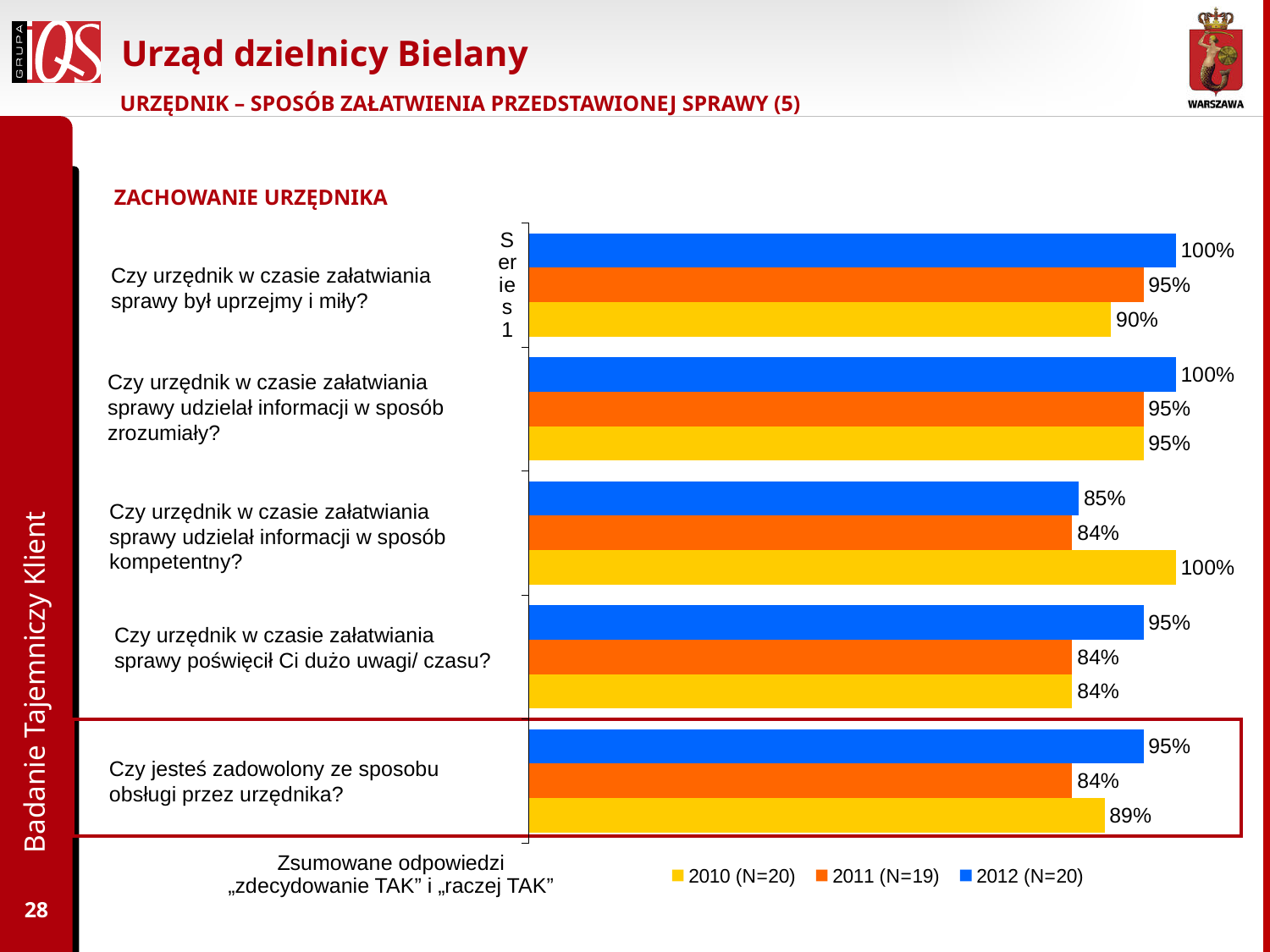
For "Czy urzędnik w czasie załatwiania sprawy udzielał informacji w sposób zrozumiały?", what is the difference between the 2012 (N=20) and 2011 (N=19) values? 5% What kind of chart is shown on the slide? bar chart What is the 2011 (N=19) value for "Czy urzędnik w czasie załatwiania sprawy poświęcił Ci dużo uwagi/ czasu?"? 84% How many series does the legend list? 3 Which colour represents the 2010 (N=20) series in the legend? yellow Which series has the lowest value for "Czy urzędnik w czasie załatwiania sprawy udzielał informacji w sposób kompetentny?"? 2011 (N=19) How many question categories are plotted on the chart? 5 What is the 2010 (N=20) value for "Czy jesteś zadowolony ze sposobu obsługi przez urzędnika?"? 89% For "Czy urzędnik w czasie załatwiania sprawy był uprzejmy i miły?", what is the difference between the 2012 (N=20) and 2010 (N=20) values? 10% For "Czy jesteś zadowolony ze sposobu obsługi przez urzędnika?", which is larger: the 2012 (N=20) value or the 2011 (N=19) value? 2012 (N=20) What is the 2010 (N=20) value for "Czy urzędnik w czasie załatwiania sprawy udzielał informacji w sposób kompetentny?"? 100% What is the 2012 (N=20) value for "Czy urzędnik w czasie załatwiania sprawy był uprzejmy i miły?"? 100%